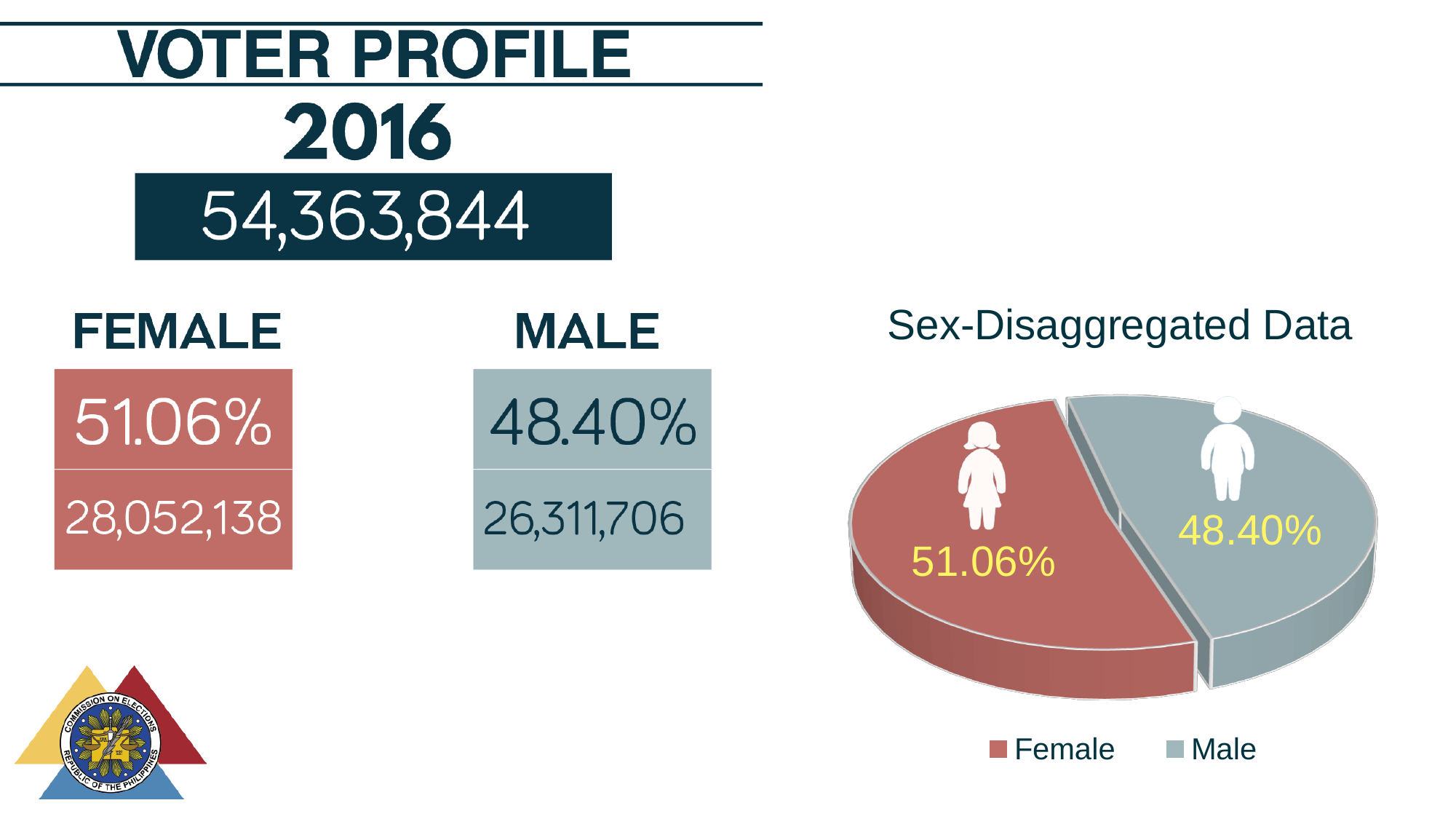
What type of chart is shown on the slide? pie chart What is the title of the chart? Sex-Disaggregated Data What colour is the Female slice in the pie chart? red What share of the pie does the Female slice represent? 51.06% Which is larger, the Female slice or the Male slice? Female What share of the pie does the Male slice represent? 48.40% How many slices does the pie chart have? 2 What is the difference in percentage points between the Female and Male slices? 2.66 Which slice of the pie is the smallest? Male How many entries does the legend list? 2 Is the Female slice greater or less than 50% of the pie? greater Which slice of the pie is the largest? Female